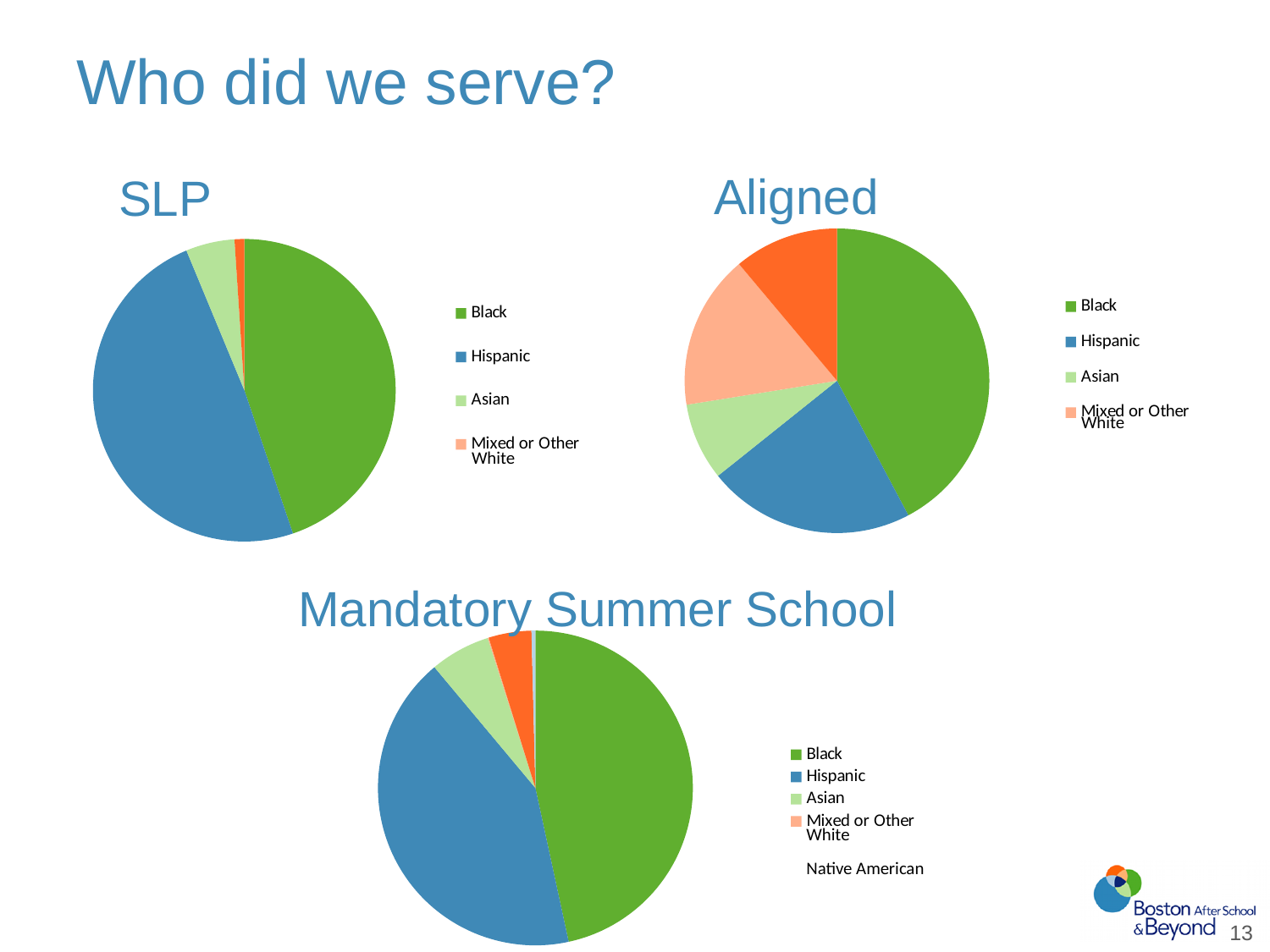
In the Aligned chart, which category has the largest slice? Black In the Aligned chart, which slice is larger, Mixed or Other or Asian? Mixed or Other In the Mandatory Summer School chart, which slice is larger, Hispanic or Asian? Hispanic What kind of chart is the SLP chart? pie chart In the SLP chart, which slice is larger, Asian or Black? Black How many pie charts are shown on the slide? 3 What is the title of the chart at the bottom of the slide? Mandatory Summer School Which legend entry appears in the Mandatory Summer School chart but not in the SLP chart? Native American In the Mandatory Summer School chart, which category has the largest slice? Black